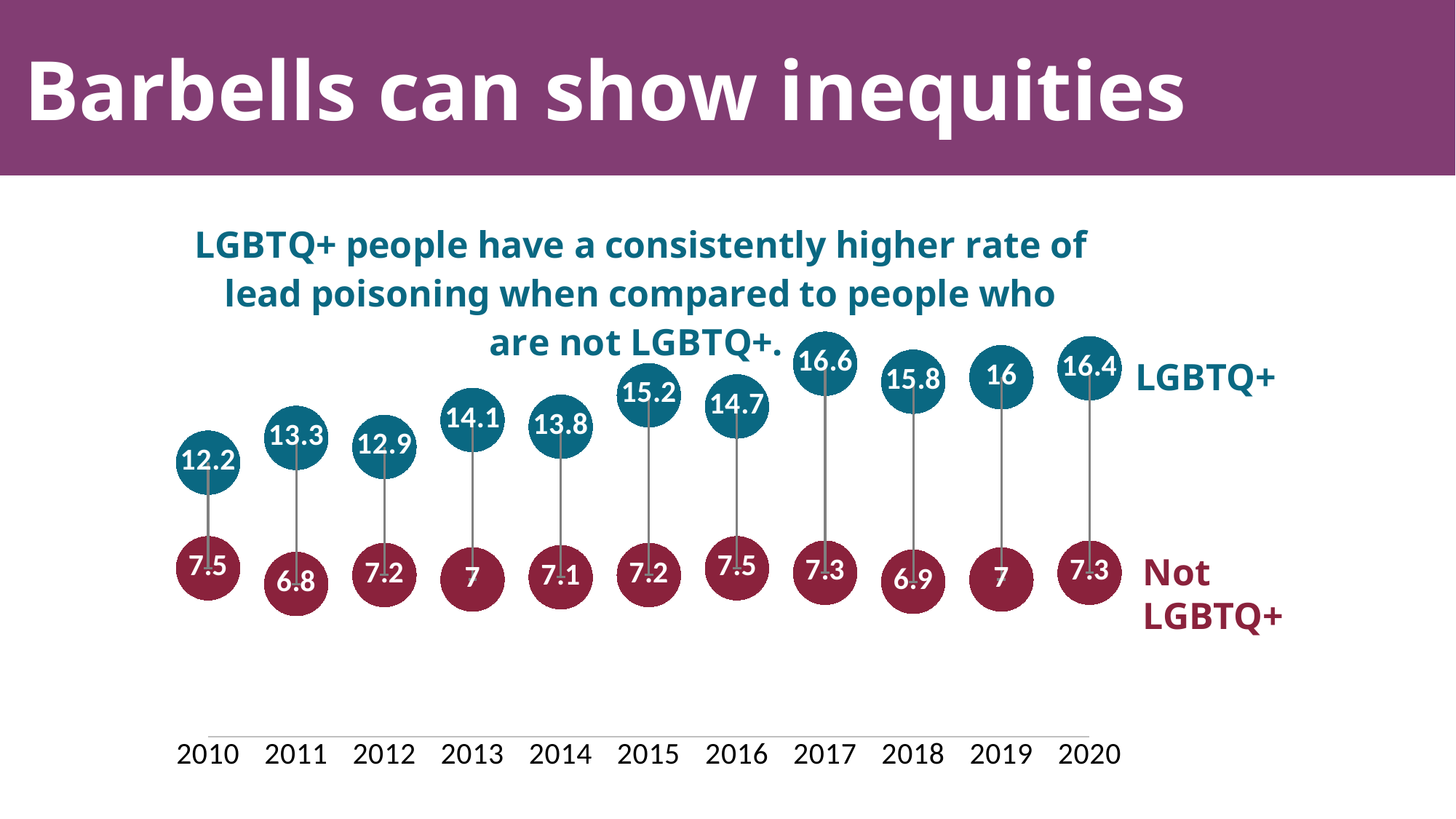
In which year is the LGBTQ+ rate highest? 2017 Does the LGBTQ+ rate generally rise or fall from 2010 to 2020? rise What is the value for Not LGBTQ+ people in 2011? 6.8 How many years are shown on the x axis? 11 Which is larger, the LGBTQ+ value in 2013 or the LGBTQ+ value in 2014? 2013 What is the difference between the LGBTQ+ and Not LGBTQ+ values in 2017? 9.3 What is the lead poisoning rate for LGBTQ+ people in 2017? 16.6 In which year is the Not LGBTQ+ rate lowest? 2011 How many series does the chart show? 2 What is the LGBTQ+ value in 2020? 16.4 In which year is the LGBTQ+ rate lowest? 2010 What is the difference between the LGBTQ+ and Not LGBTQ+ values in 2010? 4.7